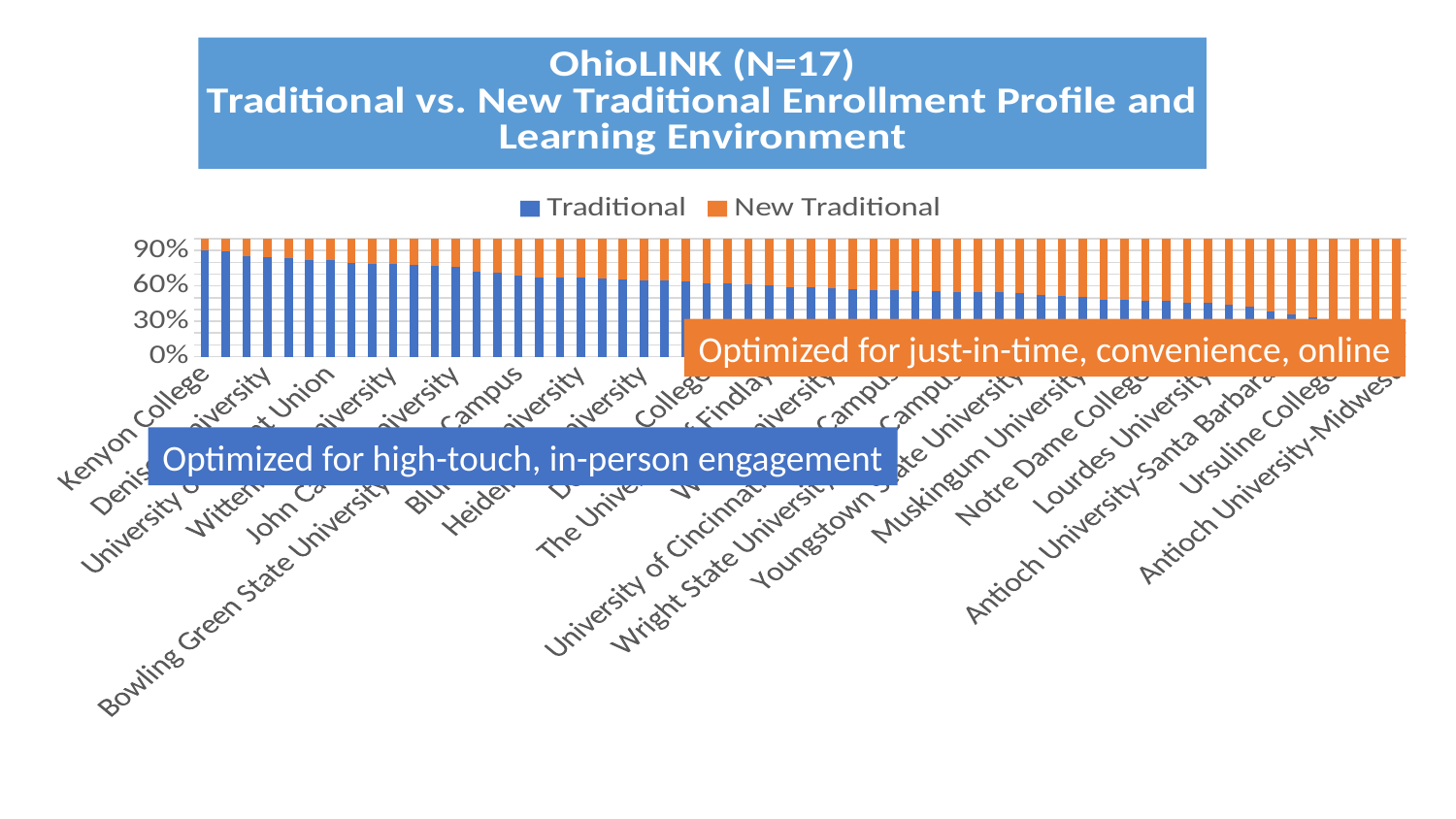
Is the Traditional value for Notre Dame College greater or less than 30%? greater Do the Traditional values rise or fall moving from left to right along the x axis? fall Which colour represents the New Traditional series? orange Which has the larger Traditional value, Kenyon College or Antioch University-Midwest? Kenyon College Is the New Traditional value for Antioch University-Midwest greater or less than 60%? greater How many series does the chart's legend list? 2 Is the New Traditional value for Kenyon College greater or less than 30%? less What kind of chart is shown on the slide? bar chart Which has the larger Traditional value, Bowling Green State University or Ursuline College? Bowling Green State University What are the two series named in the legend? Traditional and New Traditional